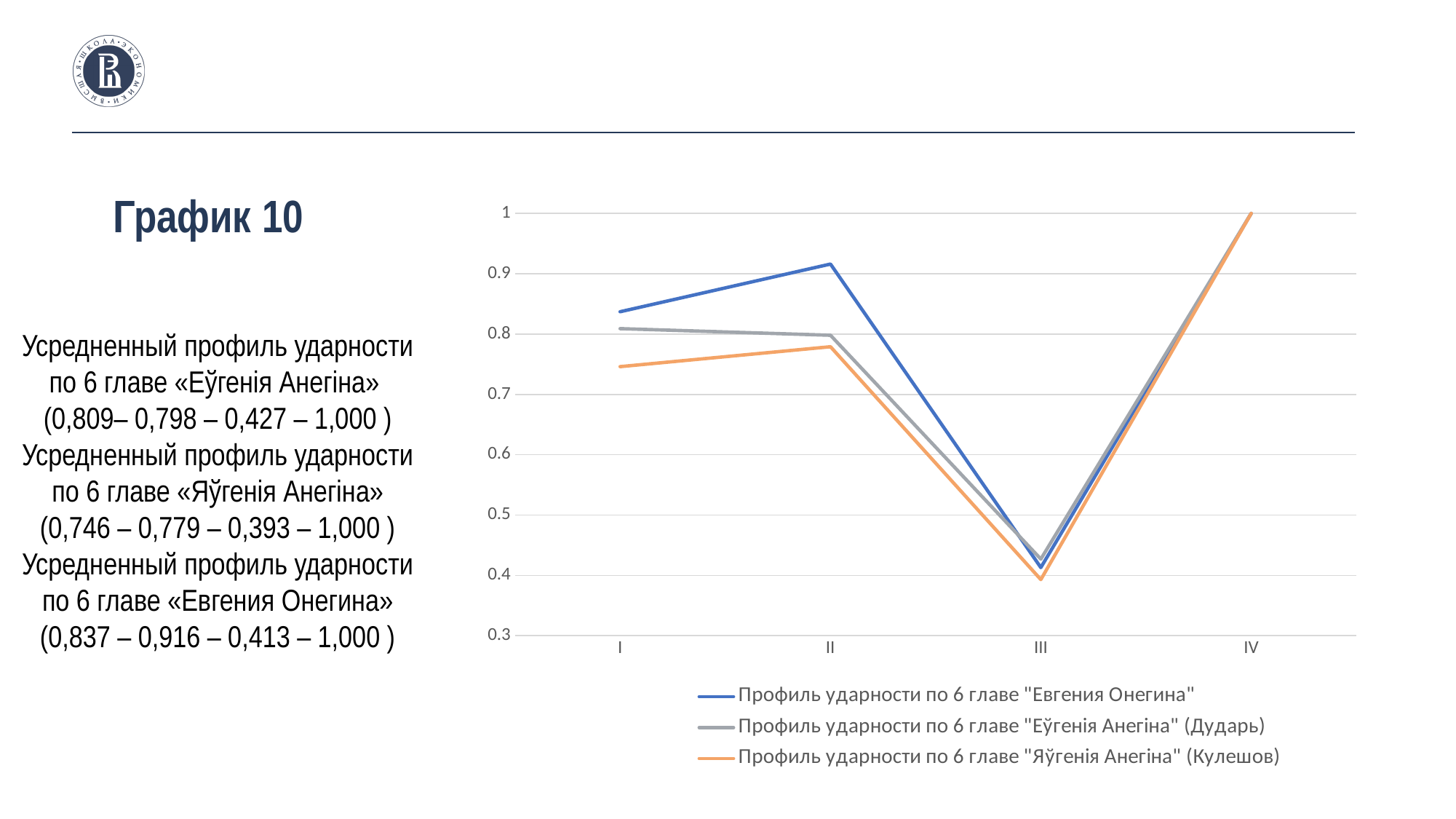
According to the slide, what is the value at point II for the "Евгения Онегина" series? 0,916 Which series has the highest value at point II? Профиль ударности по 6 главе "Евгения Онегина" Which is larger at point I: the "Евгения Онегина" series or the "Еўгенія Анегіна" (Дударь) series? Профиль ударности по 6 главе "Евгения Онегина" According to the slide, what is the value at point III for the "Яўгенія Анегіна" (Кулешов) series? 0,393 Is the value for the "Евгения Онегина" series at point II greater or less than 0.9? greater How many series does the chart legend list? 3 What is the title shown on the slide for this chart? График 10 How many points are plotted along the x axis for each series? 4 Which series has the lowest value at point I? Профиль ударности по 6 главе "Яўгенія Анегіна" (Кулешов) Is the value for the "Яўгенія Анегіна" (Кулешов) series at point III greater or less than 0.4? less Do the values of the "Евгения Онегина" series rise or fall from point II to point III? fall What kind of chart is shown on the slide? line chart